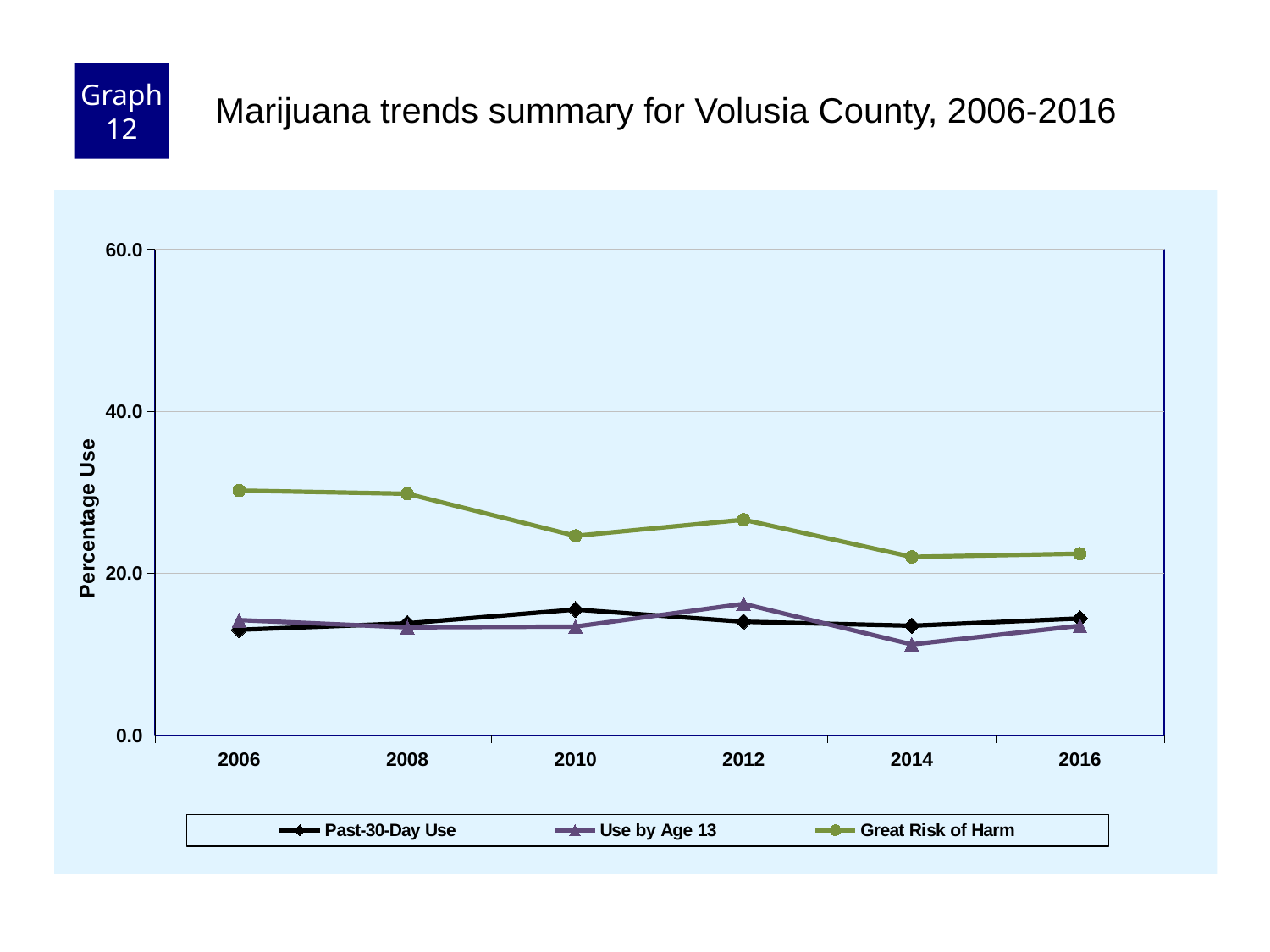
Does the Great Risk of Harm series rise or fall overall from 2006 to 2016? fall What kind of chart is shown on the slide? line chart In 2006, which is larger: Great Risk of Harm or Past-30-Day Use? Great Risk of Harm Is the value for Past-30-Day Use in 2010 greater or less than 20.0? less How many series does the legend list? 3 In which year is the Use by Age 13 series highest? 2012 In which year is the Use by Age 13 series lowest? 2014 What is the title of the chart? Marijuana trends summary for Volusia County, 2006-2016 Is the value for Great Risk of Harm in 2006 greater or less than 20.0? greater What is the label on the y axis? Percentage Use Is the value for Great Risk of Harm in 2006 greater or less than 40.0? less How many years are plotted along the x axis? 6